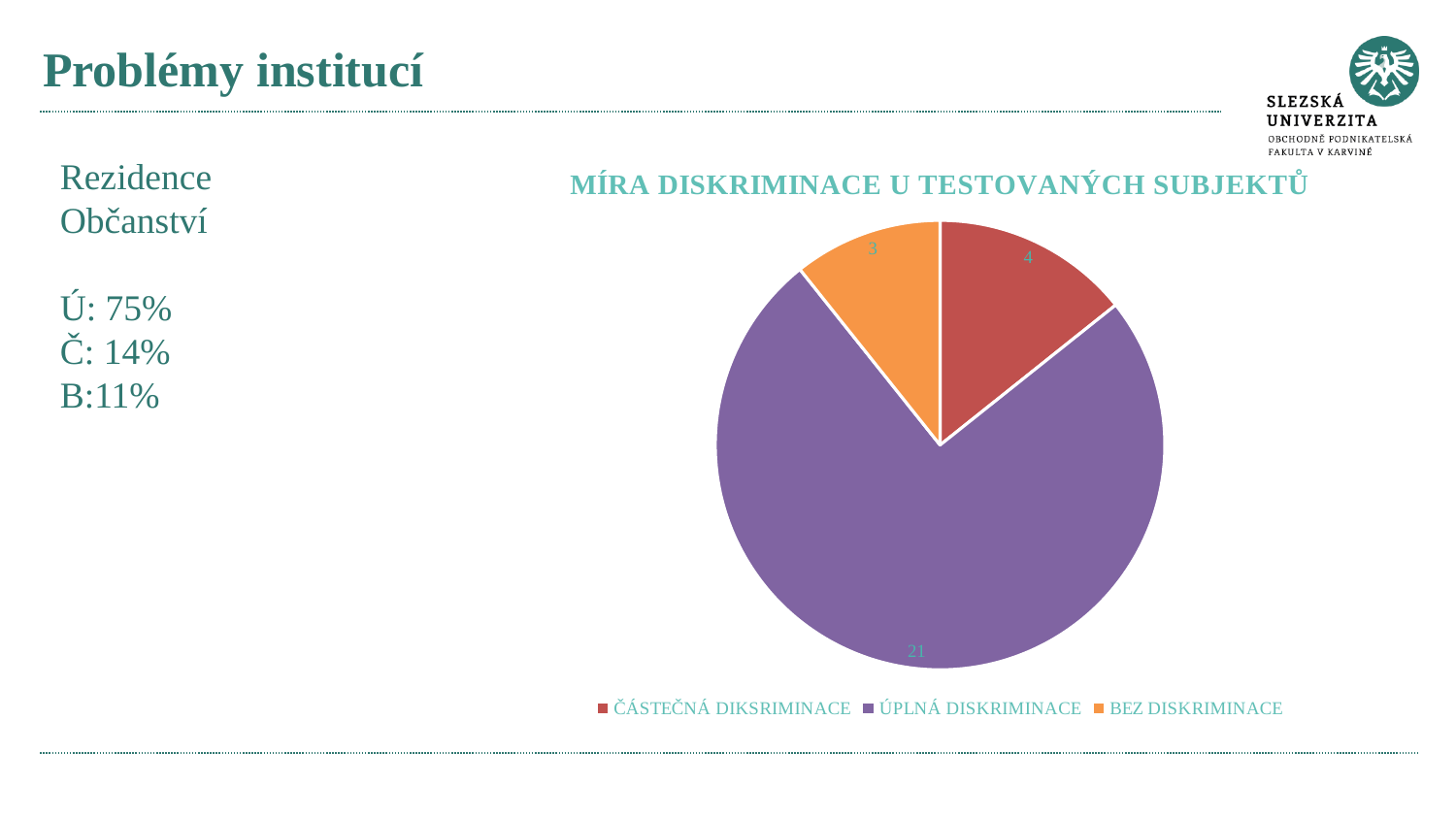
What is the value for BEZ DISKRIMINACE in the pie chart? 3 What is the value for ÚPLNÁ DISKRIMINACE in the pie chart? 21 What is the total of all slices in the pie chart? 28 Which category has the smallest slice of the pie? BEZ DISKRIMINACE What is the difference between the values for ÚPLNÁ DISKRIMINACE and ČÁSTEČNÁ DIKSRIMINACE? 17 Which is larger, the value for ČÁSTEČNÁ DIKSRIMINACE or BEZ DISKRIMINACE? ČÁSTEČNÁ DIKSRIMINACE What is the title of the chart? MÍRA DISKRIMINACE U TESTOVANÝCH SUBJEKTŮ What is the value for ČÁSTEČNÁ DIKSRIMINACE in the pie chart? 4 How many slices does the pie chart have? 3 What type of chart is shown on the slide? pie chart Which category has the largest slice of the pie? ÚPLNÁ DISKRIMINACE What share of the pie does ÚPLNÁ DISKRIMINACE represent? 75%